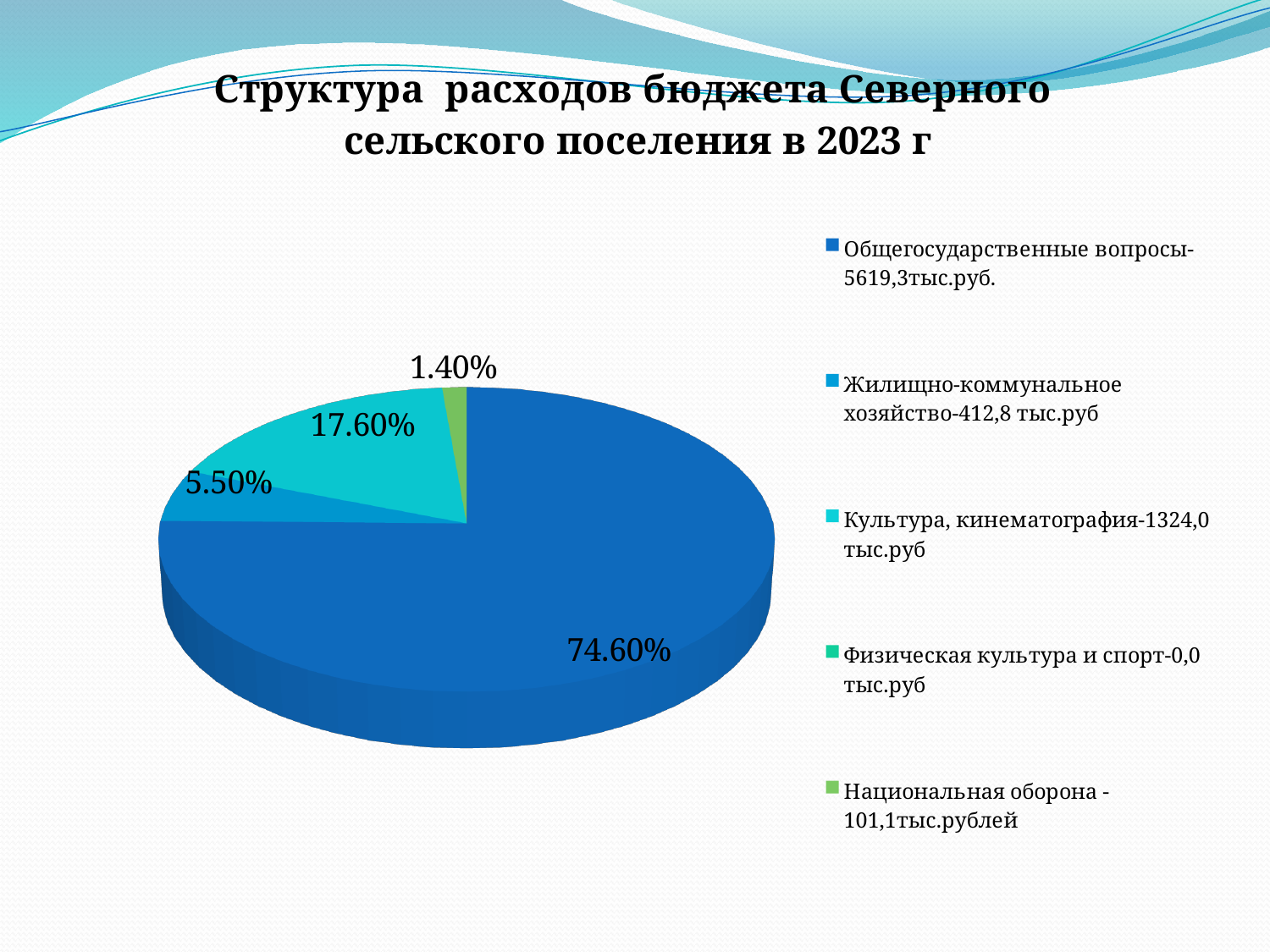
How many entries does the legend list? 5 What is the difference in percentage points between the Общегосударственные вопросы slice and the Культура, кинематография slice? 57.00 percentage points What percentage is shown for Культура, кинематография? 17.60% Which category has the smallest labelled slice on the pie? Национальная оборона Which category has the largest slice of the pie? Общегосударственные вопросы How many percentage labels are printed on the pie? 4 What kind of chart is shown on the slide? pie chart What share of the pie does Общегосударственные вопросы take? 74.60% What percentage is shown for Национальная оборона? 1.40% According to the legend, what amount in тыс.руб. is given for Общегосударственные вопросы? 5619,3 тыс.руб. Which is larger: the share for Культура, кинематография or for Жилищно-коммунальное хозяйство? Культура, кинематография What percentage is shown for Жилищно-коммунальное хозяйство? 5.50%